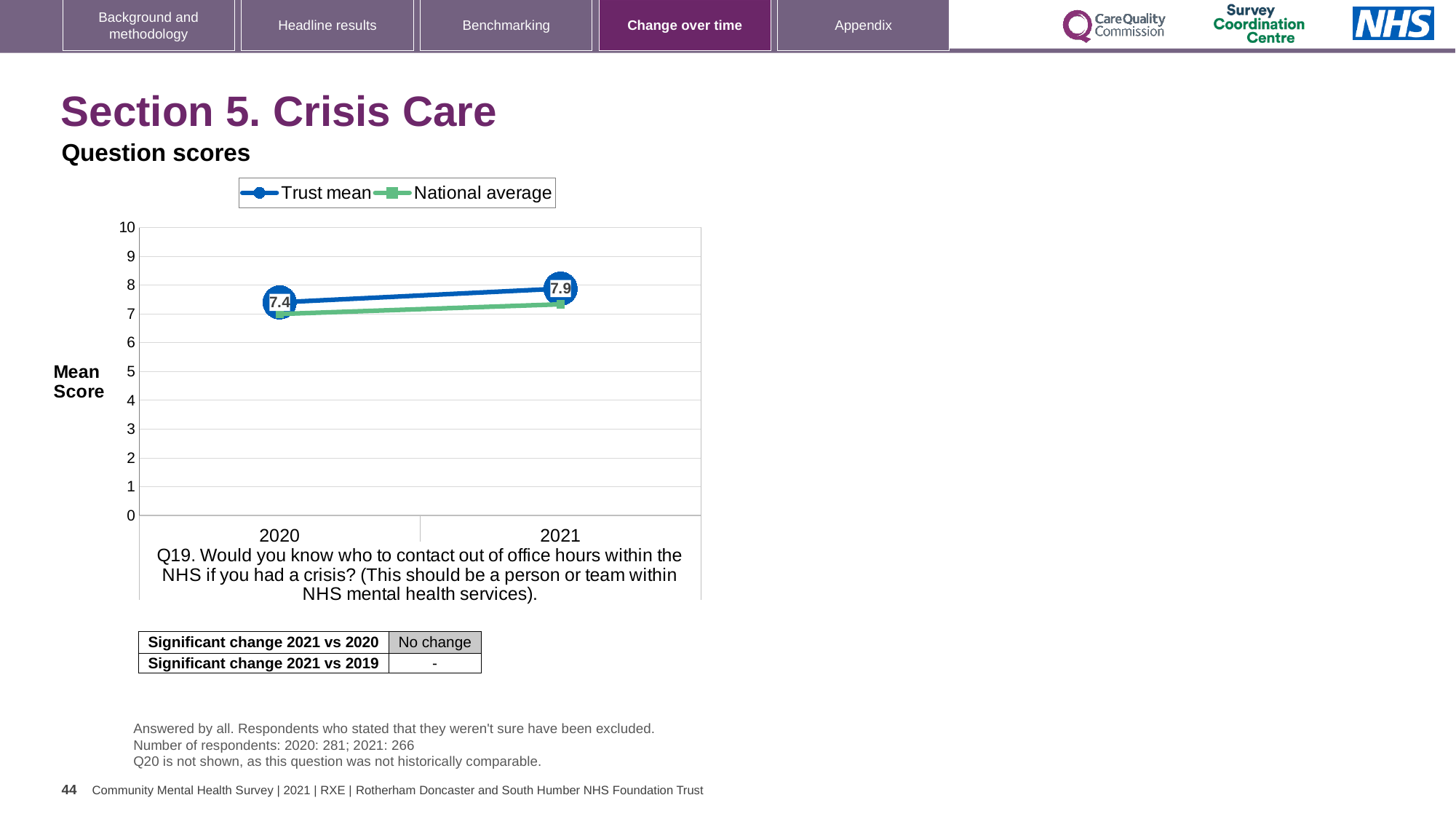
How many series does the chart legend list? 2 By how much did the Trust mean score for Q19 change from 2020 to 2021? 0.5 Which year has the higher Trust mean score for Q19? 2021 What kind of chart is shown on the slide? line chart Which year has the lower Trust mean score for Q19? 2020 How many years are plotted on the x axis of the chart? 2 What is the label on the y axis of the chart? Mean Score What is the Trust mean score for Q19 in 2021? 7.9 In 2021, which is larger for Q19: the Trust mean or the National average? Trust mean Does the Trust mean score for Q19 rise or fall from 2020 to 2021? rise Is the National average for Q19 in 2021 greater or less than 8? less What is the Trust mean score for Q19 in 2020? 7.4